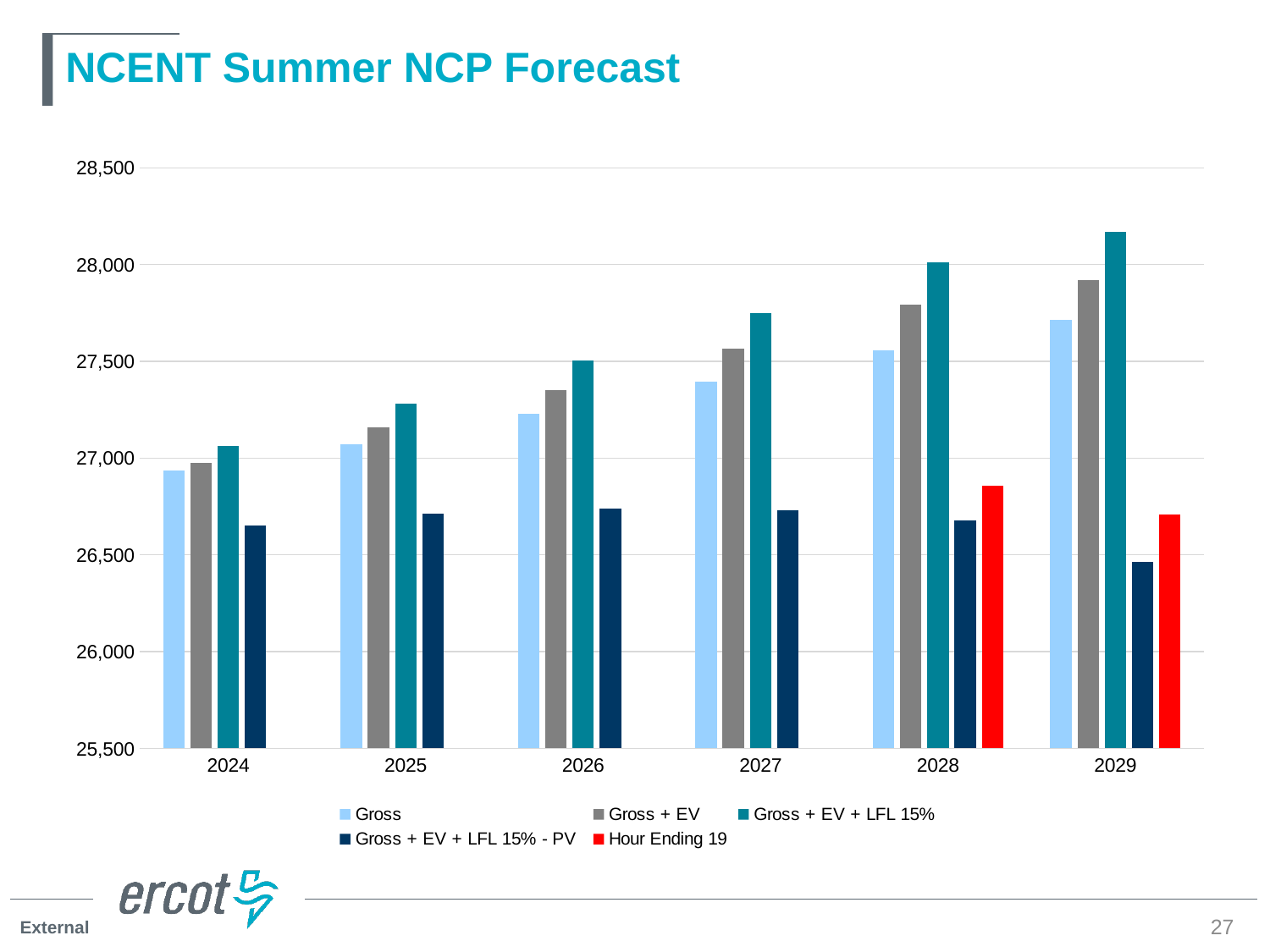
What kind of chart is shown on the slide? bar chart Which is larger, the Hour Ending 19 value for 2028 or for 2029? 2028 Which years have a Hour Ending 19 bar? 2028 and 2029 Is the Gross + EV + LFL 15% value for 2029 greater or less than 28,000? greater Is the Gross value for 2024 greater or less than 27,000? less Is the Hour Ending 19 value for 2028 greater or less than 27,000? less Which year has the lowest Gross + EV + LFL 15% - PV value? 2029 Which year has the highest Gross + EV + LFL 15% value? 2029 How many series does the legend list? 5 How many years are shown on the x axis? 6 Do the Gross values rise or fall from 2024 to 2029? rise